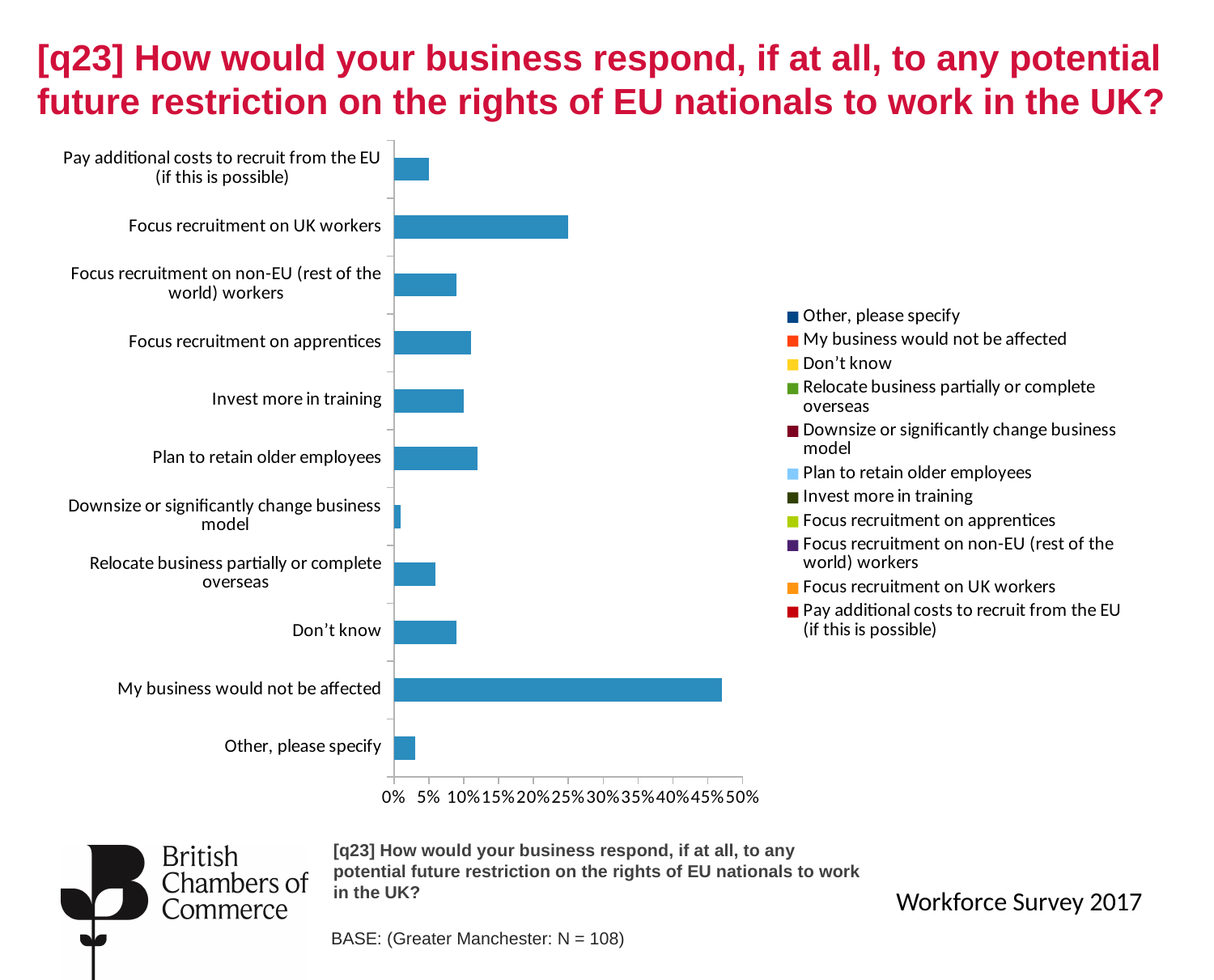
Is the value for "Downsize or significantly change business model" greater or less than 5%? less Which response has the lowest value in the chart? Downsize or significantly change business model Is the value for "My business would not be affected" greater or less than 40%? greater What kind of chart is shown on the slide? Bar chart Is the value for "Relocate business partially or complete overseas" greater or less than 10%? less Which is larger: the value for "My business would not be affected" or the value for "Other, please specify"? My business would not be affected Which response has the highest value in the chart? My business would not be affected How many entries does the legend list? 11 How many response categories are plotted in the chart? 11 Which is larger: the value for "Focus recruitment on UK workers" or the value for "Invest more in training"? Focus recruitment on UK workers What is the highest percentage tick shown on the chart's horizontal axis? 50%